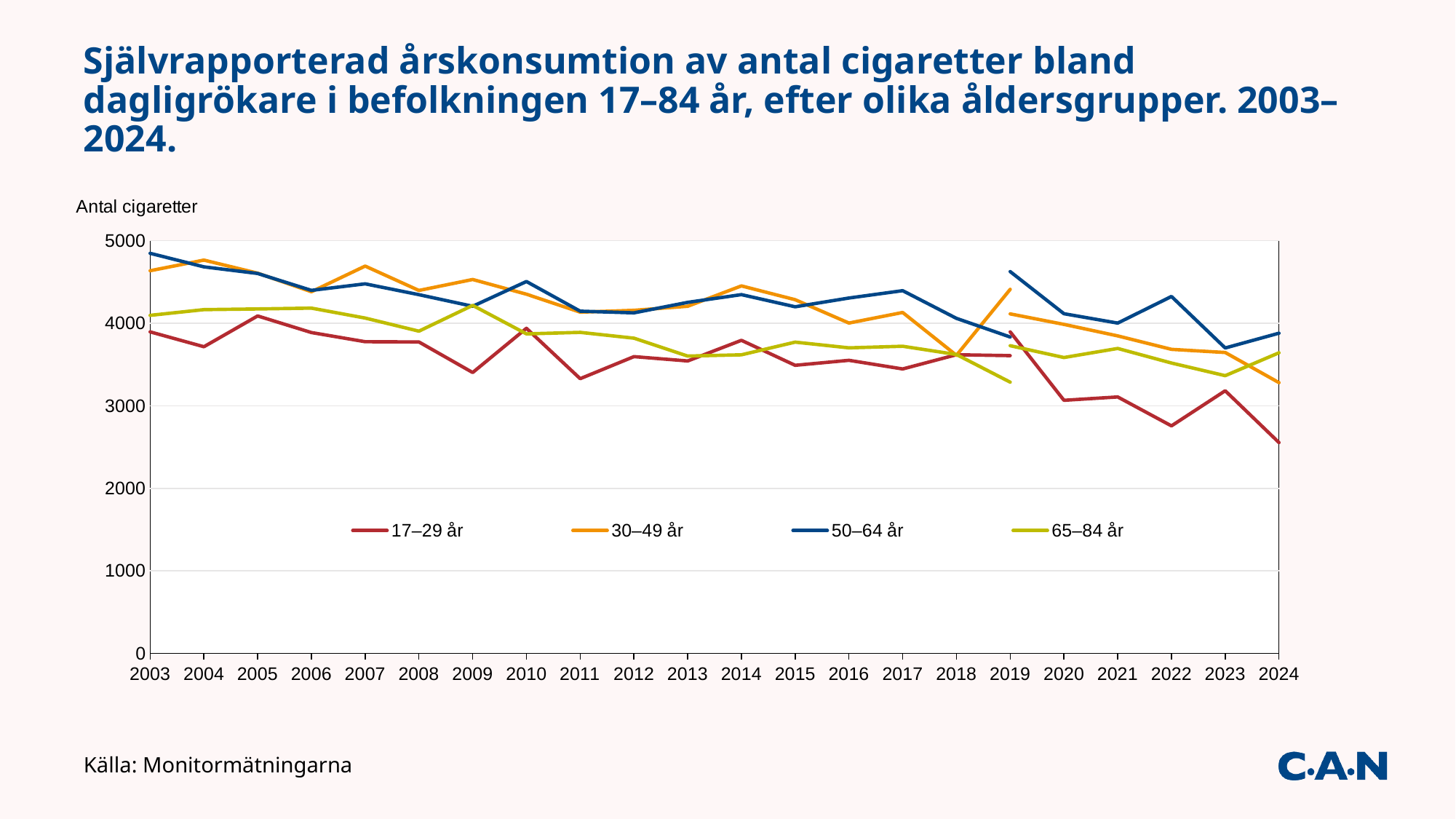
In 2024, which is larger: the value for 50–64 år or the value for 17–29 år? 50–64 år Is the value for 50–64 år in 2003 greater or less than 4000? greater Is the value for 17–29 år in 2024 greater or less than 3000? less What kind of chart is shown on the slide? Line chart How many series does the legend list? 4 What is the label on the vertical axis of the chart? Antal cigaretter Which age group has the lowest value in 2024? 17–29 år Which age group has the highest value in 2003? 50–64 år Is the value for 30–49 år in 2019 greater or less than 4000? greater Does the 17–29 år series generally rise or fall from 2003 to 2024? Fall How many years are plotted along the x axis? 22